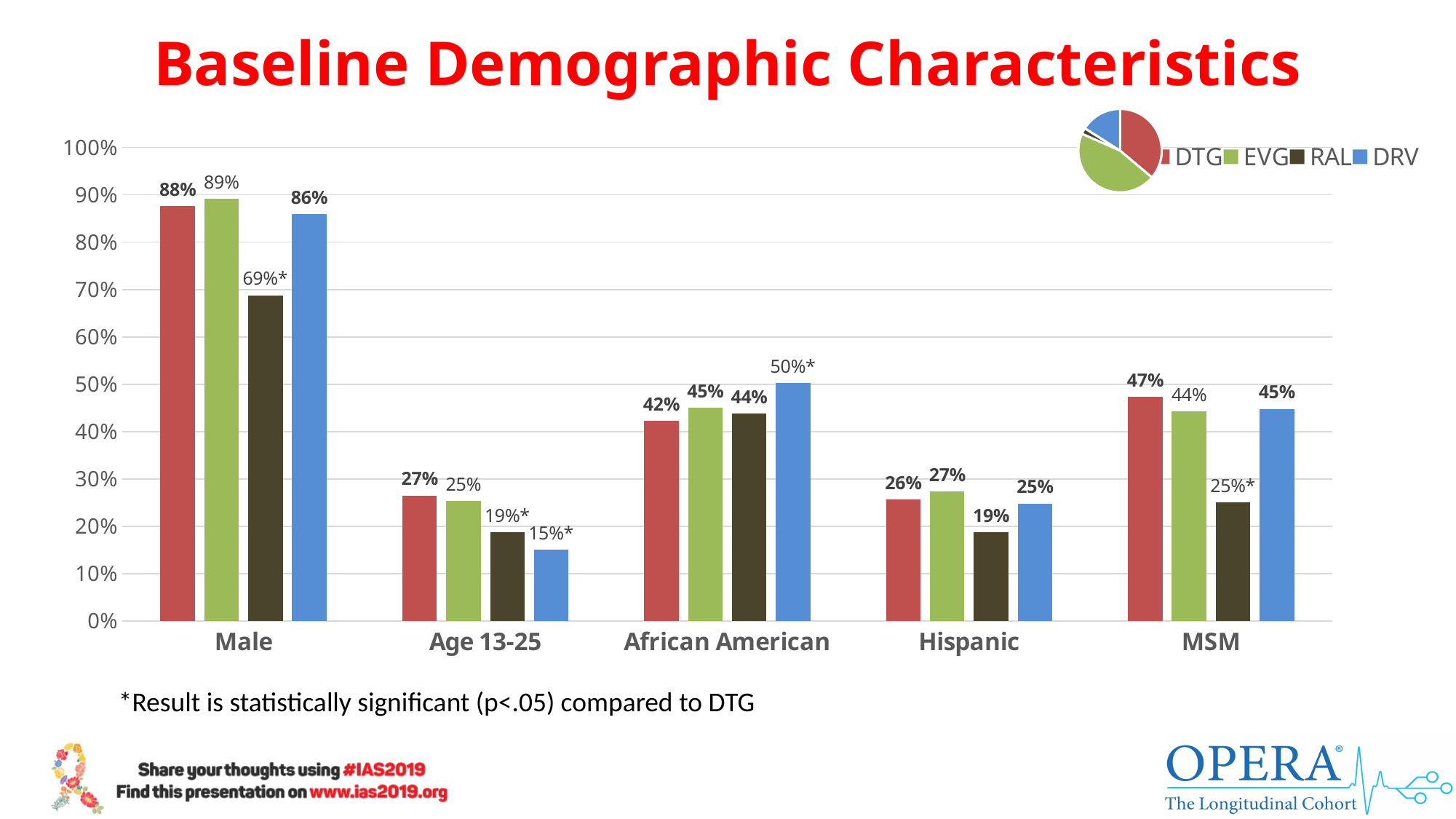
In the bar chart, which series has the lowest value in the Age 13-25 category? DRV What type of chart is the large chart on the slide? bar chart How many categories are shown on the x axis of the bar chart? 5 How many series does the legend of the bar chart list? 4 In the bar chart, what is the value for DRV in the African American category? 50%* In the bar chart, what is the value for DTG in the MSM category? 47% In the bar chart, what is the value for RAL in the Male category? 69%* In the bar chart, what is the value for EVG in the Hispanic category? 27% In the bar chart, is the value for RAL in the Hispanic category greater or less than 20%? less In the bar chart, what is the difference between the DTG and RAL values in the Male category? 19 percentage points In the bar chart, which is larger in the MSM category, the DTG value or the EVG value? DTG In the bar chart, which series has the highest value in the African American category? DRV